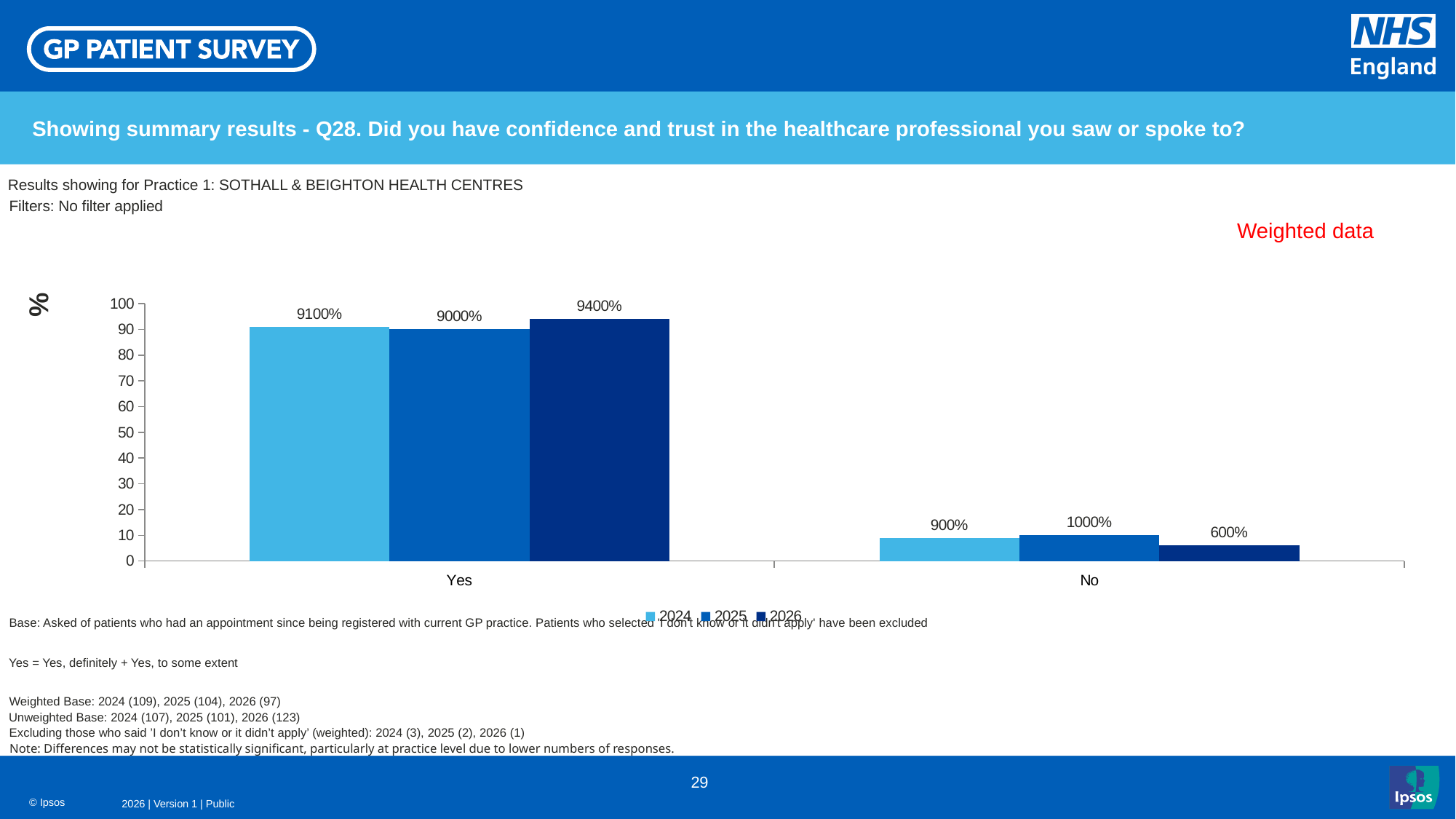
Is the 2025 bar in the Yes category greater or less than 50 on the axis? greater What is the data label shown for the 2025 series in the No category? 1000% How many series does the legend list? 3 What kind of chart is shown on the slide? Bar chart How many categories are shown on the x axis? 2 What are the series names listed in the legend? 2024, 2025, 2026 What is the data label shown for the 2026 series in the Yes category? 9400% What is the data label shown for the 2026 series in the No category? 600% Which is larger in the No category: the 2024 bar or the 2025 bar? 2025 Which year has the lowest bar in the No category? 2026 Which year has the highest bar in the Yes category? 2026 What is the data label shown for the 2024 series in the Yes category? 9100%